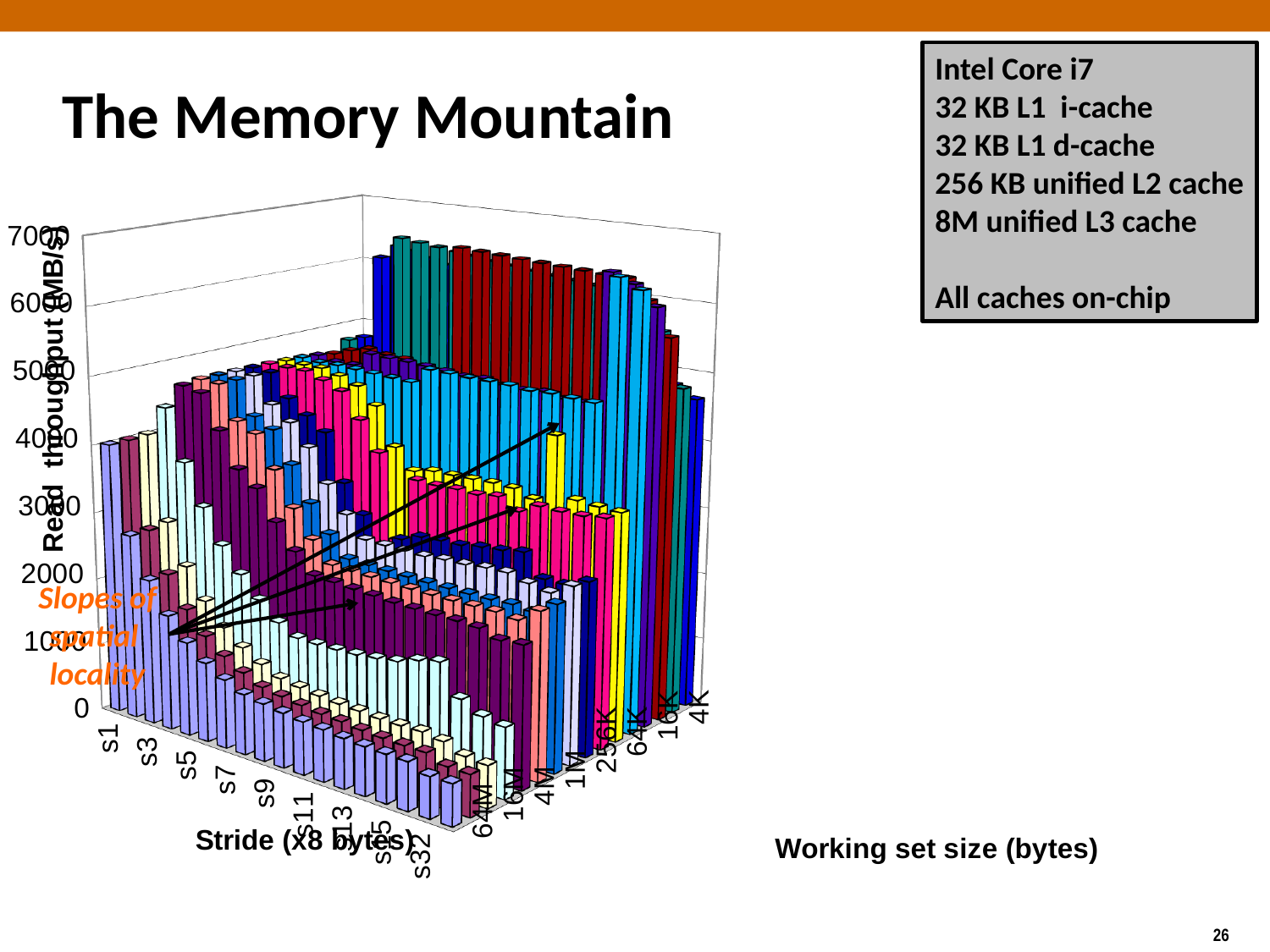
What is the label of the vertical axis of the chart? Read throughput (MB/s) For the 64M working set size, does read throughput rise or fall as the stride increases from s1 to s32? fall What is the highest tick value shown on the vertical axis of the chart? 7000 What kind of chart is shown on the slide? bar chart Is the value for stride s32 at working set size 64M greater or less than 2000? less Is the tallest bar on the chart greater or less than 6000? greater What is the title of the chart on the slide? The Memory Mountain